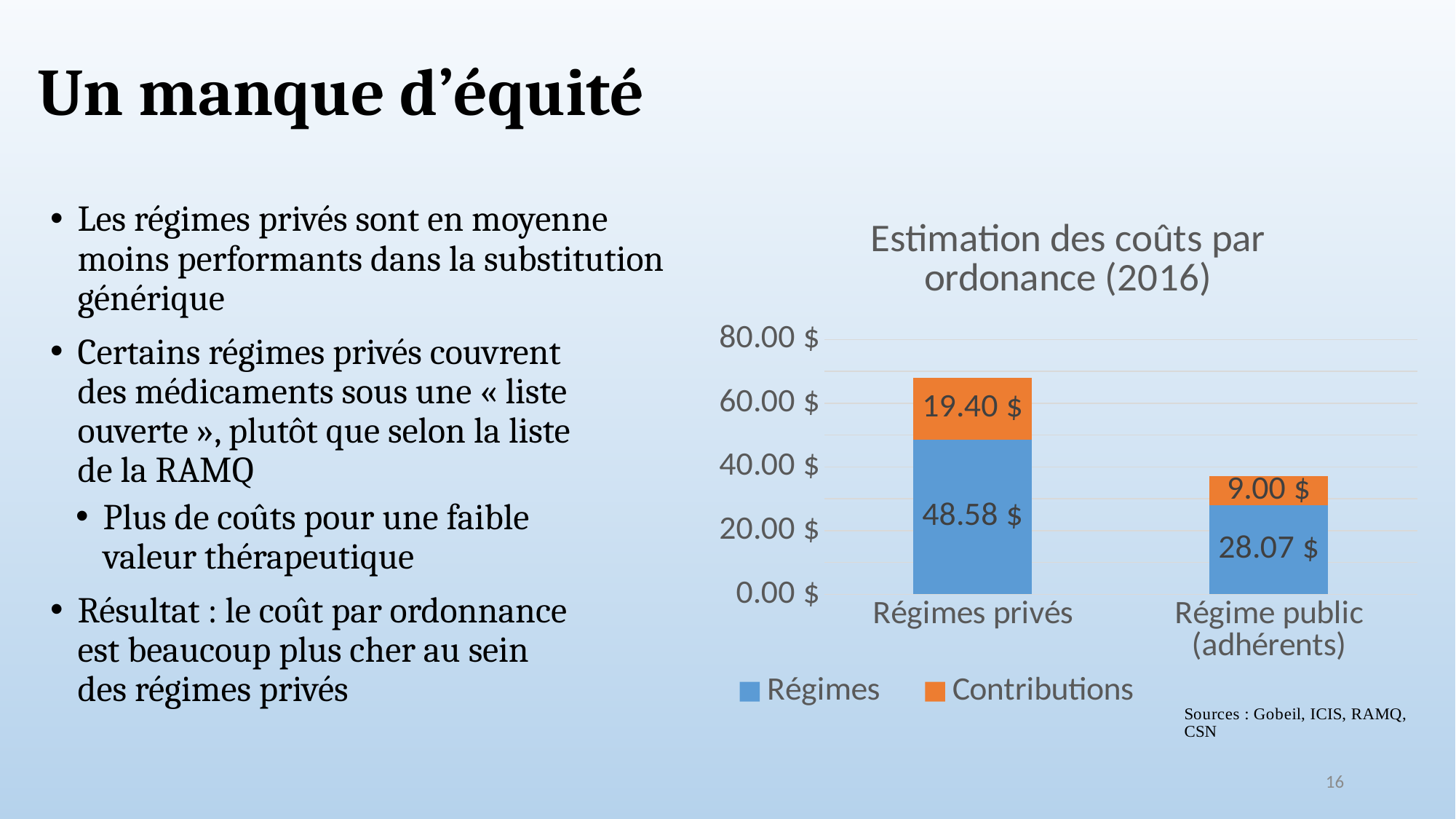
What type of chart is shown on the slide? Stacked bar chart How many series does the legend list? 2 What is the total of the stacked bar for Régimes privés? 67.98 $ What is the total of the stacked bar for Régime public (adhérents)? 37.07 $ What is the difference between the Régimes values for Régimes privés and Régime public (adhérents)? 20.51 $ What is the value of the Contributions series for Régimes privés? 19.40 $ How many categories are shown on the x axis? 2 What is the value of the Contributions series for Régime public (adhérents)? 9.00 $ What is the value of the Régimes series for Régimes privés? 48.58 $ What is the value of the Régimes series for Régime public (adhérents)? 28.07 $ Which category has the lower Contributions value? Régime public (adhérents) Which category has the higher Régimes value? Régimes privés